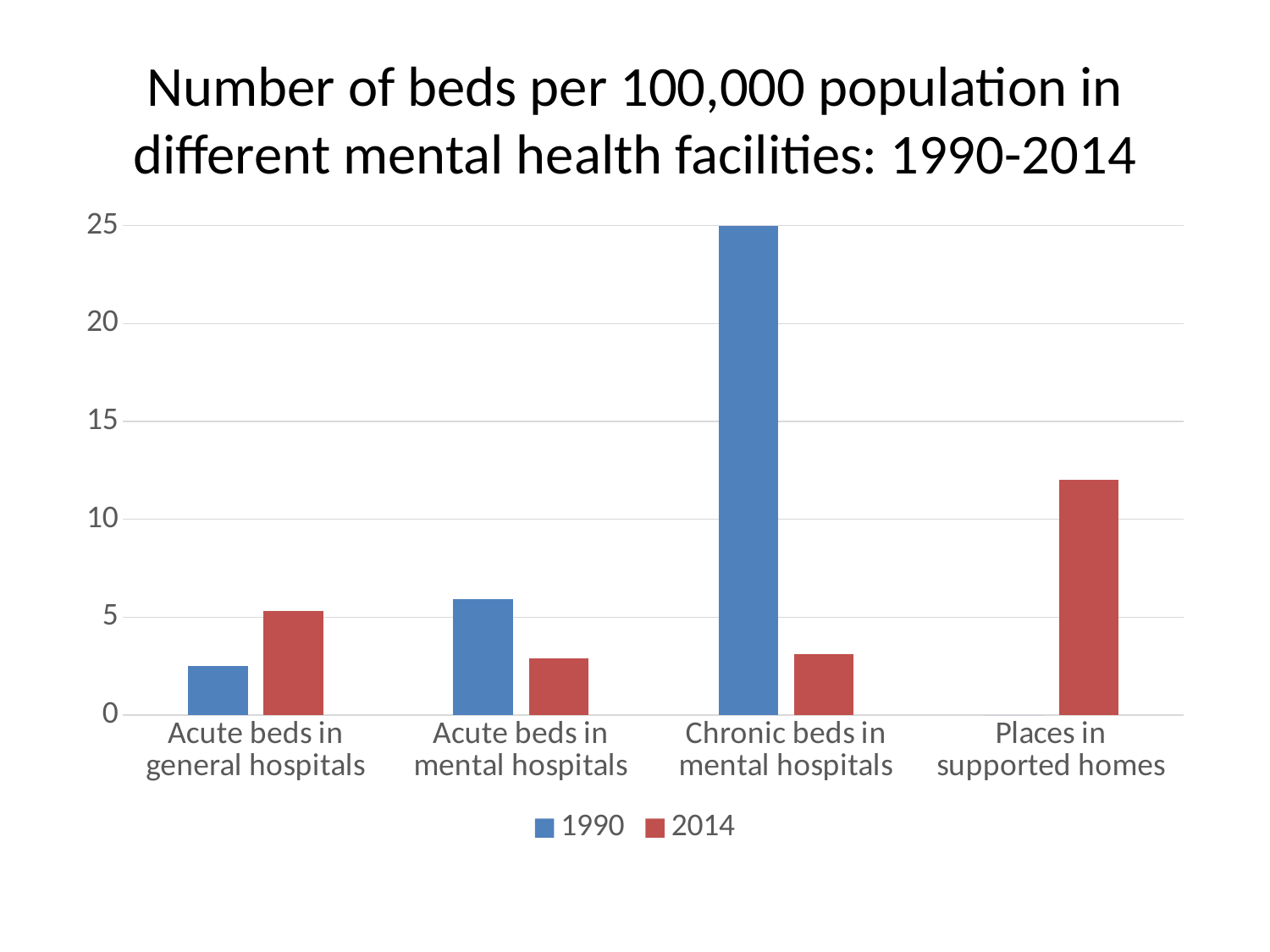
For Acute beds in general hospitals, which is larger: the 1990 value or the 2014 value? 2014 How many series does the legend list? 2 Which category has the lowest 1990 value? Places in supported homes What kind of chart is shown on the slide? bar chart Which category has the highest 1990 value? Chronic beds in mental hospitals How many categories are shown on the x axis? 4 What is the title of the chart? Number of beds per 100,000 population in different mental health facilities: 1990-2014 Is the 2014 value for Places in supported homes greater or less than 10? greater Which category has the highest 2014 value? Places in supported homes Is the 1990 value for Acute beds in general hospitals greater or less than 5? less For Acute beds in mental hospitals, which is larger: the 1990 value or the 2014 value? 1990